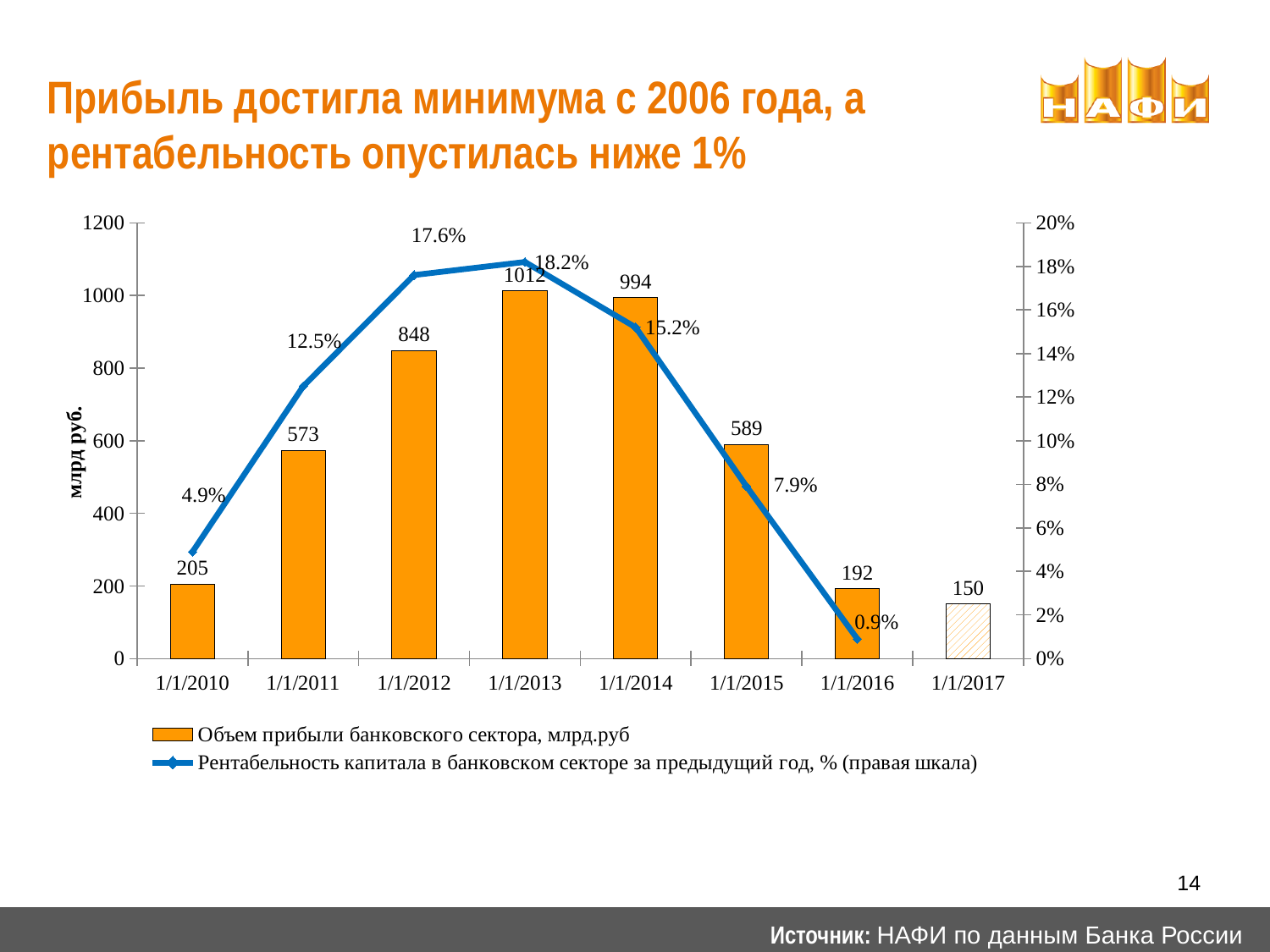
What is the label of the left vertical axis? млрд руб. Which date has the highest bank sector profit volume? 1/1/2013 How many series does the legend list? 2 How many dates are shown on the x axis of the chart? 8 What is the bank sector profit volume (млрд.руб) for 1/1/2013? 1012 Which date has the lowest bank sector profit volume? 1/1/2017 What is the profit volume shown for 1/1/2017? 150 What is the difference between the profit volume for 1/1/2013 and 1/1/2014? 18 What kind of chart is used for the profit volume series? bar chart Which is larger: the profit volume for 1/1/2011 or for 1/1/2015? 1/1/2015 What is the return on capital (Рентабельность капитала) value shown for 1/1/2016? 0.9% Does the return on capital line rise or fall from 1/1/2013 to 1/1/2016? fall